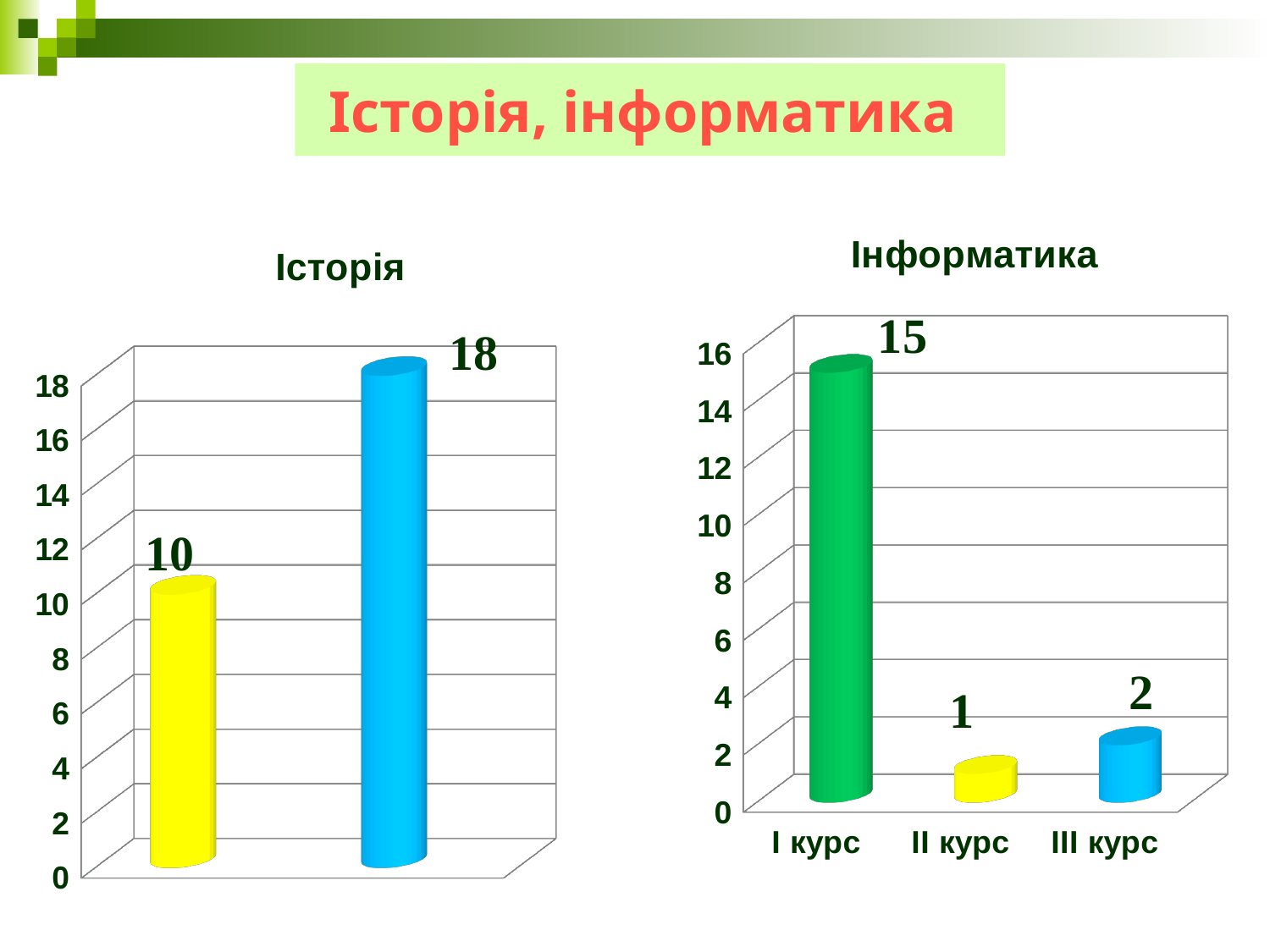
In the "Історія" chart, what is the value of the yellow bar? 10 What kind of chart is the "Історія" chart? bar chart In the "Історія" chart, what is the value of the blue bar? 18 In the "Інформатика" chart, how many categories are shown? 3 In the "Інформатика" chart, what is the value for II курс? 1 In the "Інформатика" chart, what is the difference between the values for I курс and III курс? 13 In the "Інформатика" chart, which is larger, the value for II курс or III курс? III курс In the "Історія" chart, what is the difference between the blue bar and the yellow bar? 8 In the "Інформатика" chart, which category has the lowest value? II курс In the "Інформатика" chart, which category has the highest value? I курс In the "Інформатика" chart, what is the value for III курс? 2 In the "Інформатика" chart, what is the value for I курс? 15